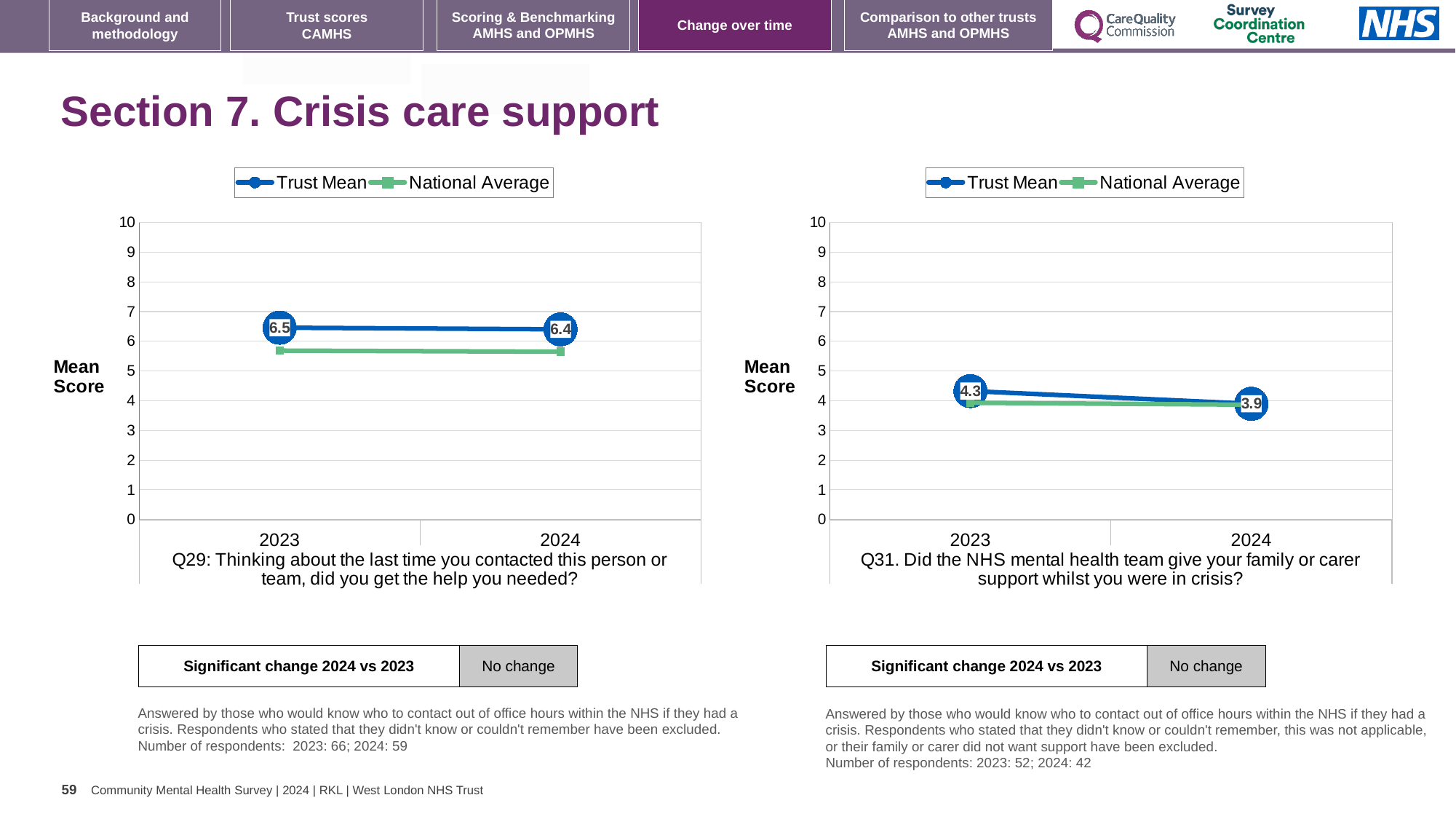
In the Q29 chart on the left, what is the Trust Mean score for 2023? 6.5 What kind of chart is the Q31 chart on the right? line chart How many series does the legend of the Q29 chart on the left list? 2 In the Q29 chart on the left, which is larger for 2023: the Trust Mean or the National Average? Trust Mean In the Q31 chart on the right, what is the Trust Mean score for 2024? 3.9 What is the label on the y axis of the Q29 chart on the left? Mean Score In the Q29 chart on the left, what is the Trust Mean score for 2024? 6.4 In the Q29 chart on the left, is the National Average value for 2023 greater or less than 6? less How many years are plotted on the x axis of the Q31 chart on the right? 2 In the Q31 chart on the right, what is the Trust Mean score for 2023? 4.3 In the Q31 chart on the right, by how much did the Trust Mean score fall from 2023 to 2024? 0.4 In the Q29 chart on the left, does the Trust Mean rise or fall from 2023 to 2024? fall